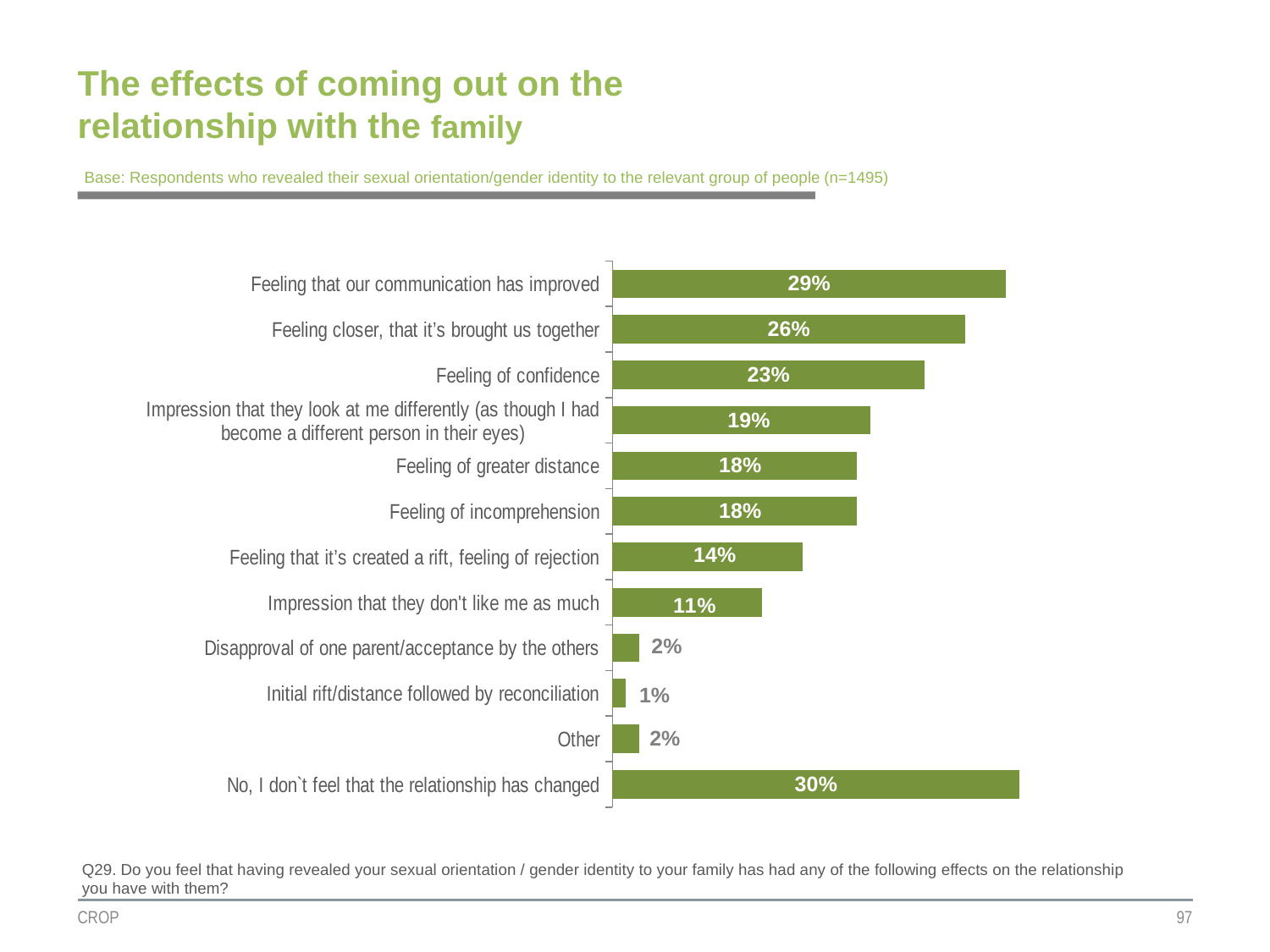
What percentage is shown for 'Impression that they don't like me as much'? 11% Which category has the highest value? No, I don`t feel that the relationship has changed What percentage of respondents reported 'Feeling that our communication has improved'? 29% What is the difference between 'Feeling closer, that it's brought us together' and 'Feeling of greater distance'? 8% What is the difference between 'Feeling that our communication has improved' and 'Feeling of incomprehension'? 11% Which category has the lowest value? Initial rift/distance followed by reconciliation What is the base size (n) stated on the slide? 1495 What is the value for 'Initial rift/distance followed by reconciliation'? 1% What kind of chart is shown on the slide? Bar chart What is the value for 'Feeling of confidence'? 23% How many categories are shown in the chart? 12 Which is larger: 'Feeling that it's created a rift, feeling of rejection' or 'Impression that they look at me differently (as though I had become a different person in their eyes)'? Impression that they look at me differently (as though I had become a different person in their eyes)